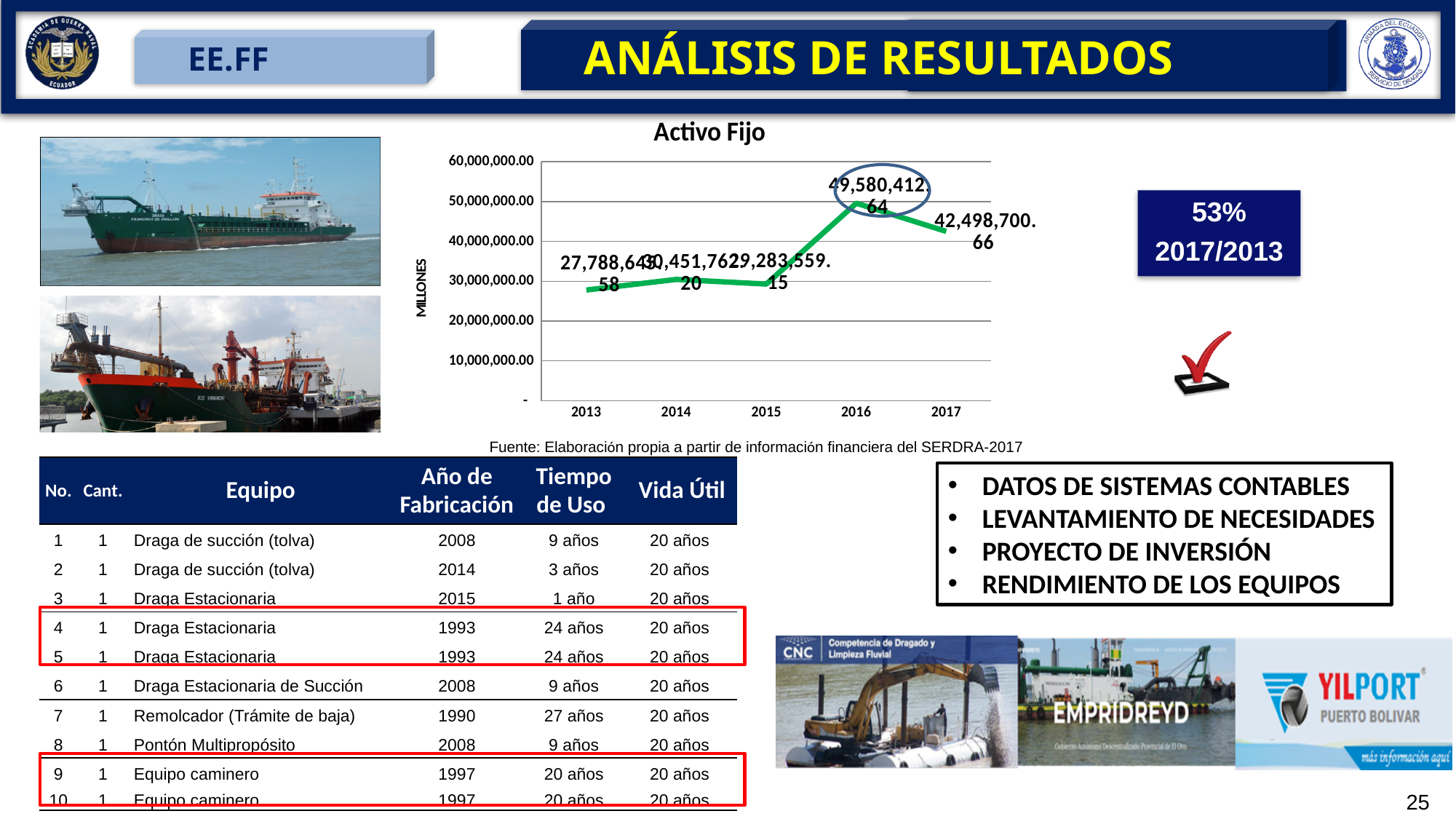
Is the value for 2013 on the Activo Fijo chart greater or less than 30,000,000.00? less What is the difference between the 2016 and 2017 values on the Activo Fijo chart? 7,081,711.98 What is the value for 2015 on the Activo Fijo chart? 29,283,559.15 What is the value for 2016 on the Activo Fijo chart? 49,580,412.64 Which is larger on the Activo Fijo chart, the value for 2016 or the value for 2017? 2016 Which year has the highest value on the Activo Fijo chart? 2016 Which year has the lowest value on the Activo Fijo chart? 2013 What is the value for 2017 on the Activo Fijo chart? 42,498,700.66 What is the title of the chart? Activo Fijo Does the value on the Activo Fijo chart rise or fall from 2016 to 2017? fall How many years are plotted on the Activo Fijo chart? 5 What kind of chart is the Activo Fijo chart? line chart